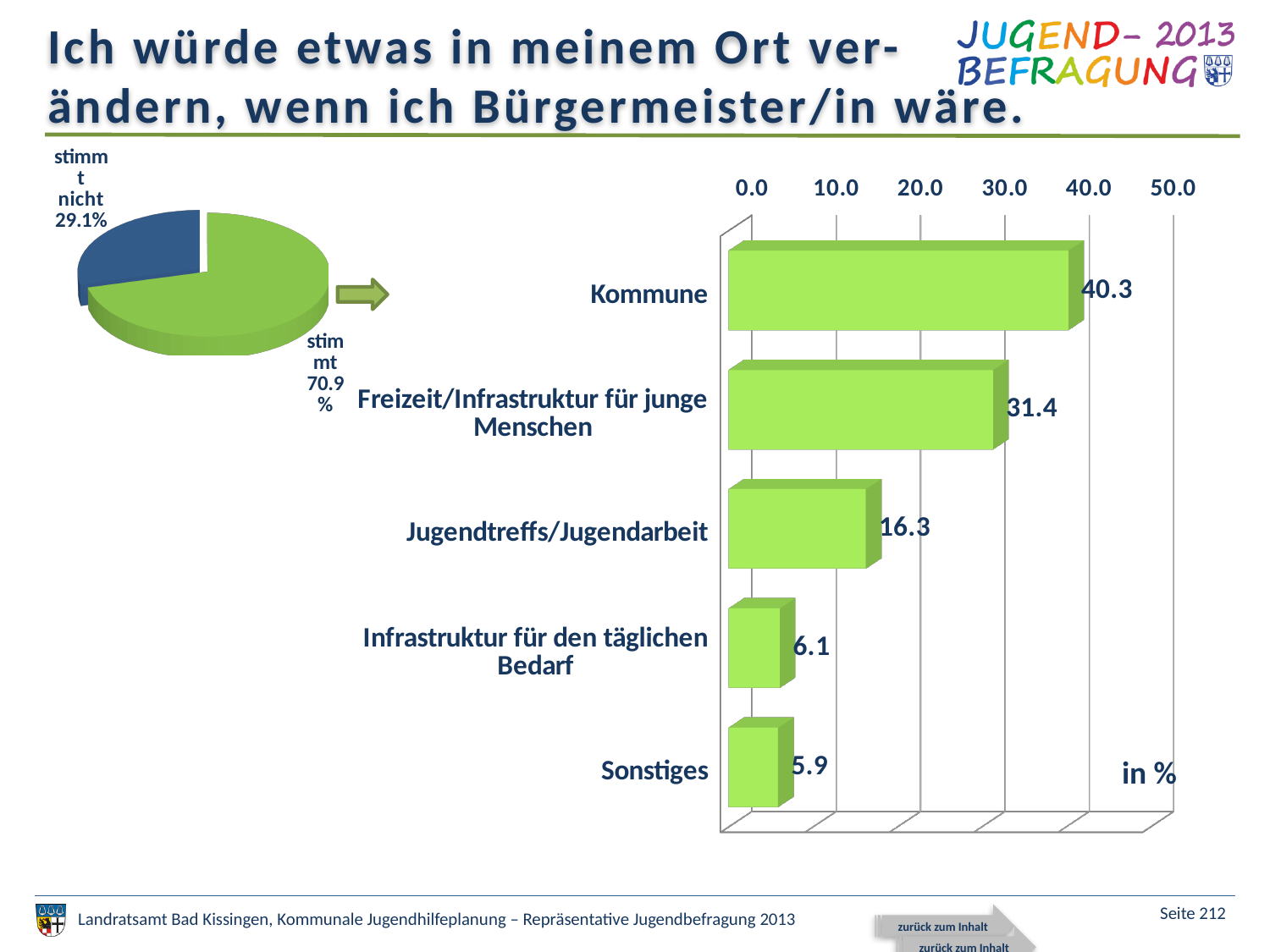
What kind of chart is shown on the right side of the slide? bar chart In the pie chart on the left, which slice is larger, "stimmt" or "stimmt nicht"? stimmt In the bar chart on the right, what is the difference between the values for Kommune and Freizeit/Infrastruktur für junge Menschen? 8.9 In the pie chart on the left, how many slices are there? 2 In the bar chart on the right, what is the value for Kommune? 40.3 In the bar chart on the right, what is the value for Jugendtreffs/Jugendarbeit? 16.3 In the bar chart on the right, what is the value for Freizeit/Infrastruktur für junge Menschen? 31.4 In the bar chart on the right, how many categories are shown? 5 In the pie chart on the left, what share is labelled "stimmt nicht"? 29.1% In the bar chart on the right, which category has the highest value? Kommune In the pie chart on the left, what share is labelled "stimmt"? 70.9% In the bar chart on the right, which category has the lowest value? Sonstiges